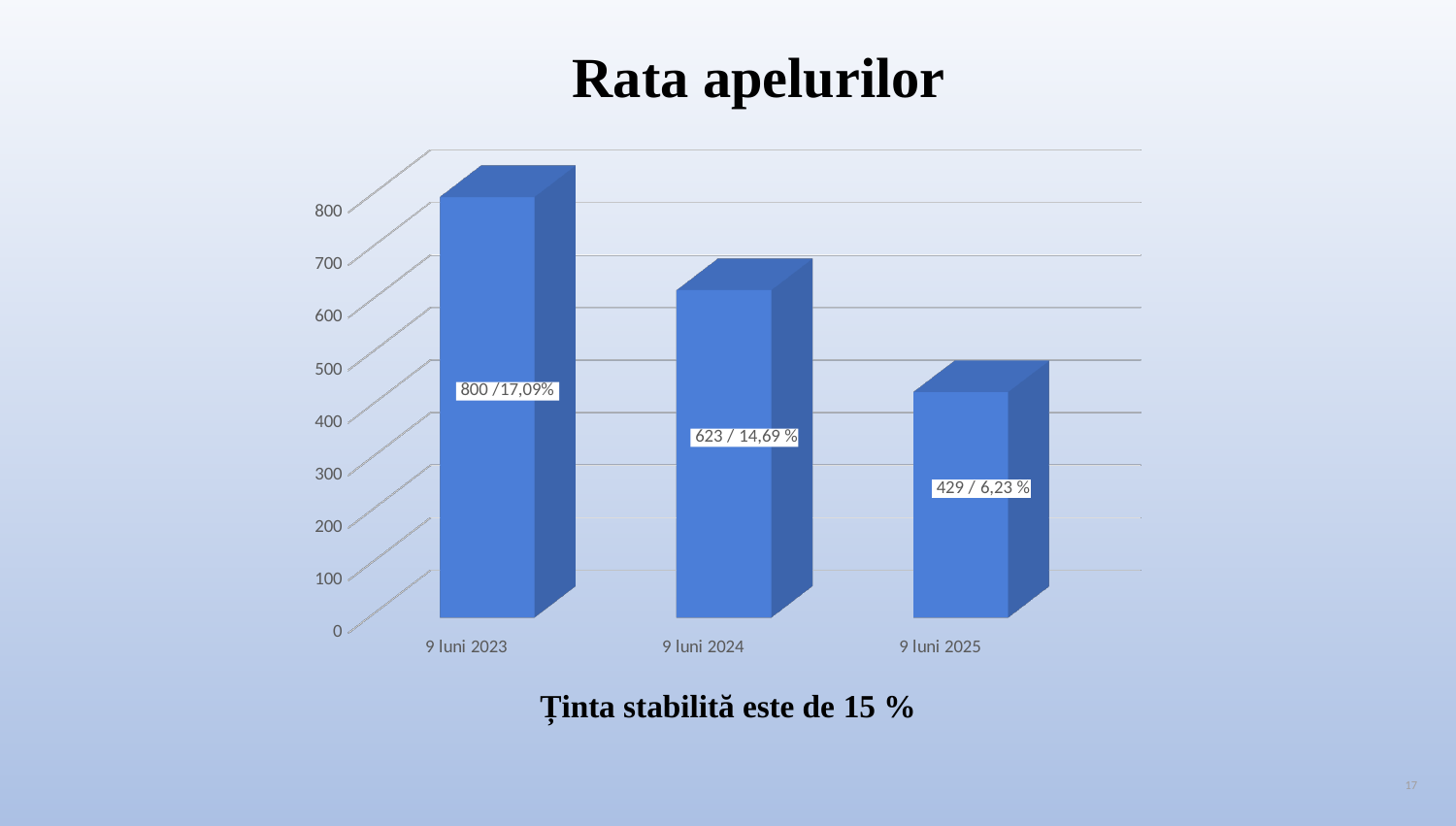
Which category has the highest bar? 9 luni 2023 What is the difference between the count for 9 luni 2023 and the count for 9 luni 2025? 371 What is the difference between the count for 9 luni 2023 and the count for 9 luni 2024? 177 Which is larger, the value for 9 luni 2024 or the value for 9 luni 2025? 9 luni 2024 Which category has the lowest bar? 9 luni 2025 Do the values rise or fall from 9 luni 2023 to 9 luni 2025? Fall Is the value for 9 luni 2024 greater or less than 500? greater What is the data label shown on the bar for 9 luni 2024? 623 / 14,69 % What is the data label shown on the bar for 9 luni 2023? 800 /17,09% How many categories are shown on the x axis? 3 What kind of chart is shown on the slide? Bar chart What is the data label shown on the bar for 9 luni 2025? 429 / 6,23 %